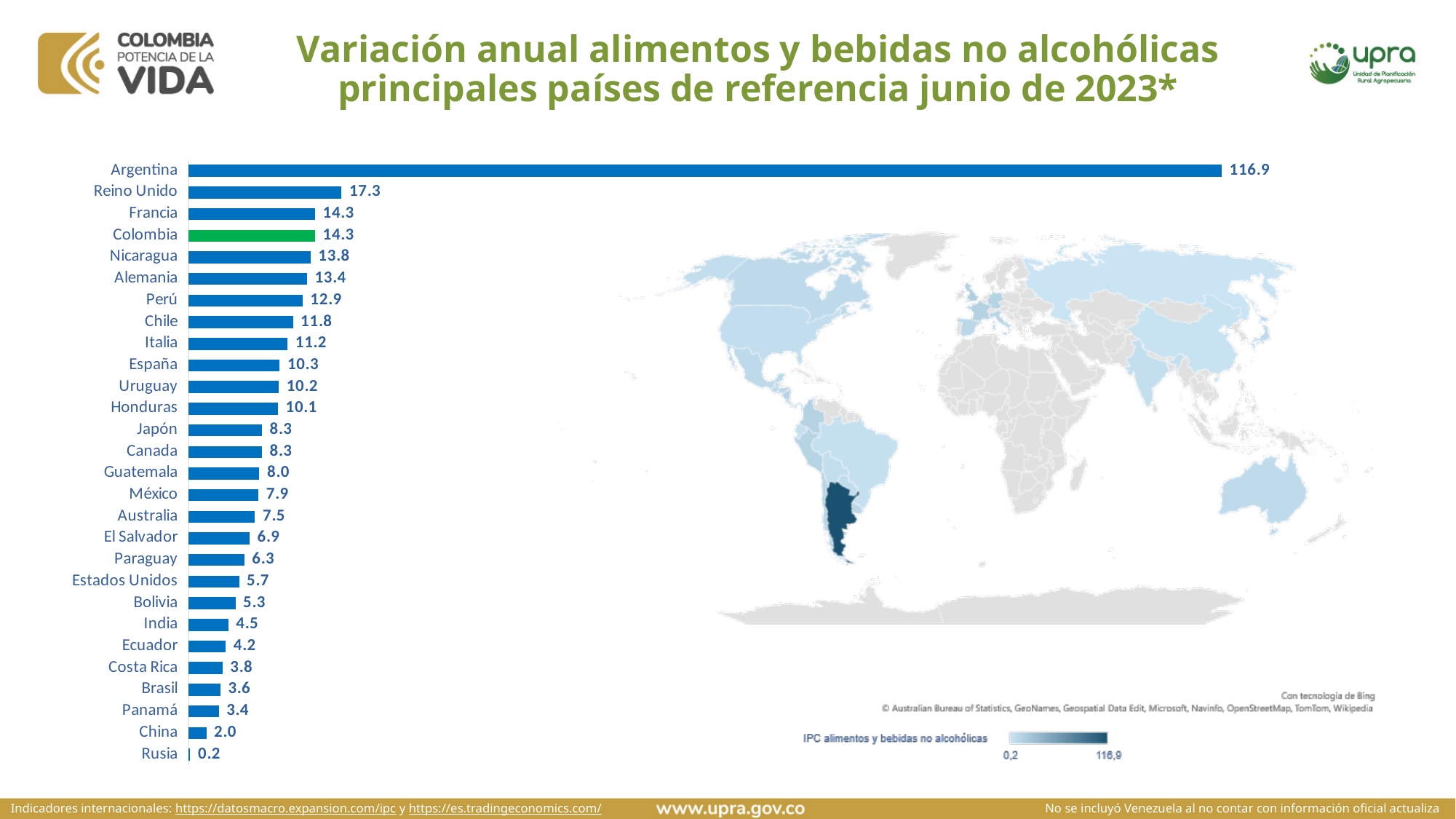
In the bar chart, what is the difference between the values for Chile and Perú? 1.1 In the bar chart, what is the difference between the values for Argentina and Reino Unido? 99.6 In the bar chart, which country has the highest value? Argentina In the bar chart, which has a larger value, Nicaragua or Alemania? Nicaragua How many countries are shown in the bar chart? 28 What type of chart is used on the left side of the slide to show the values by country? Bar chart In the bar chart, which country's bar is coloured green instead of blue? Colombia In the bar chart, which country has the lowest value? Rusia In the bar chart, which has a larger value, Brasil or Costa Rica? Costa Rica In the bar chart, what is the value for Argentina? 116.9 In the bar chart, what is the value for Colombia? 14.3 In the bar chart, what is the value for Estados Unidos? 5.7